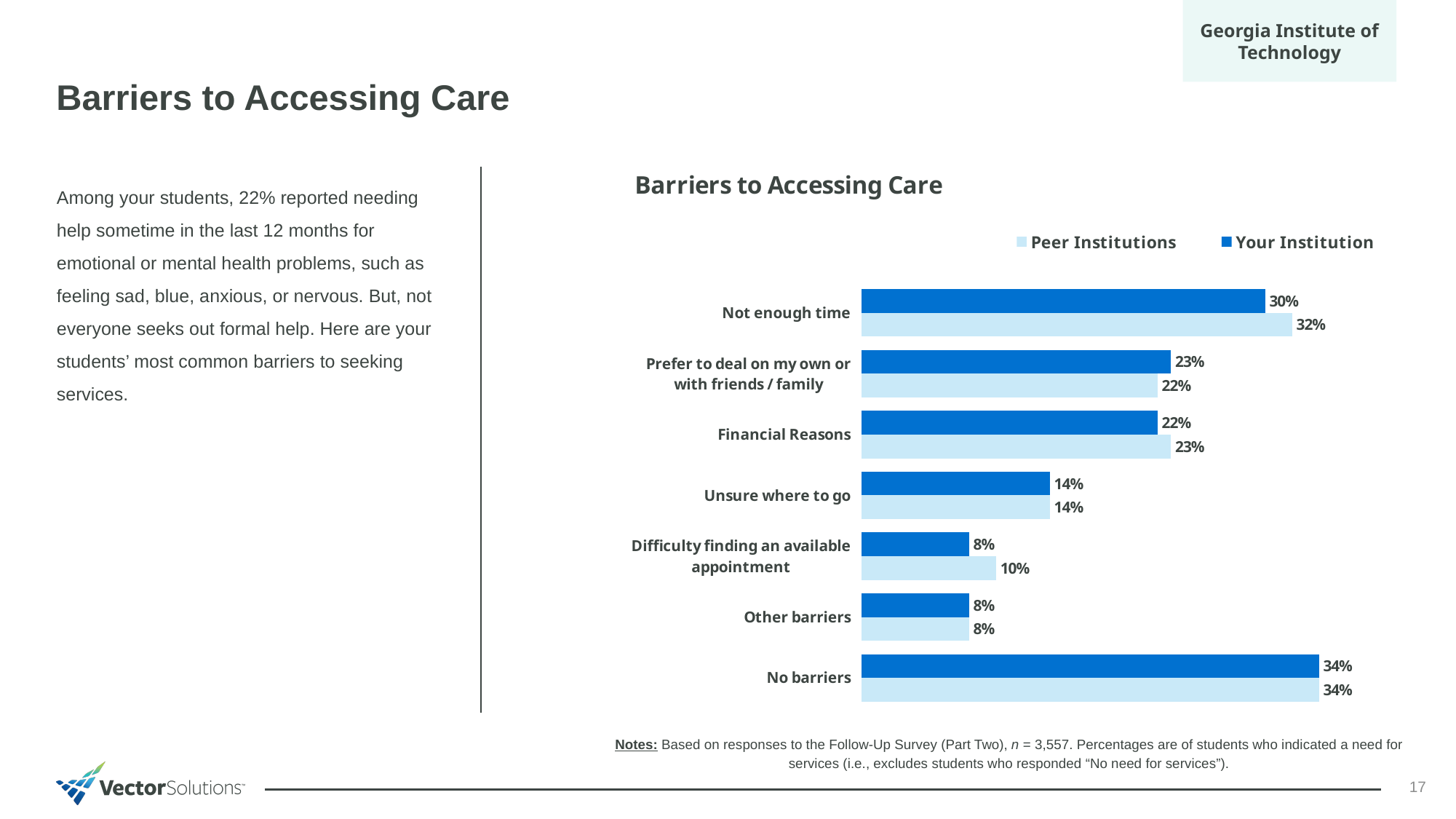
What is the title of the chart? Barriers to Accessing Care What is the Peer Institutions value for Difficulty finding an available appointment? 10% For Difficulty finding an available appointment, which series has the larger value, Peer Institutions or Your Institution? Peer Institutions How many series does the legend list? 2 What kind of chart is shown on the slide? Bar chart What is the Peer Institutions value for Not enough time? 32% What is the Your Institution value for Financial Reasons? 22% Which category has the lowest Peer Institutions value? Other barriers How many categories are shown in the chart? 7 Which category has the highest Your Institution value? No barriers What is the Your Institution value for Not enough time? 30% What is the difference between the Peer Institutions and Your Institution values for Not enough time? 2%